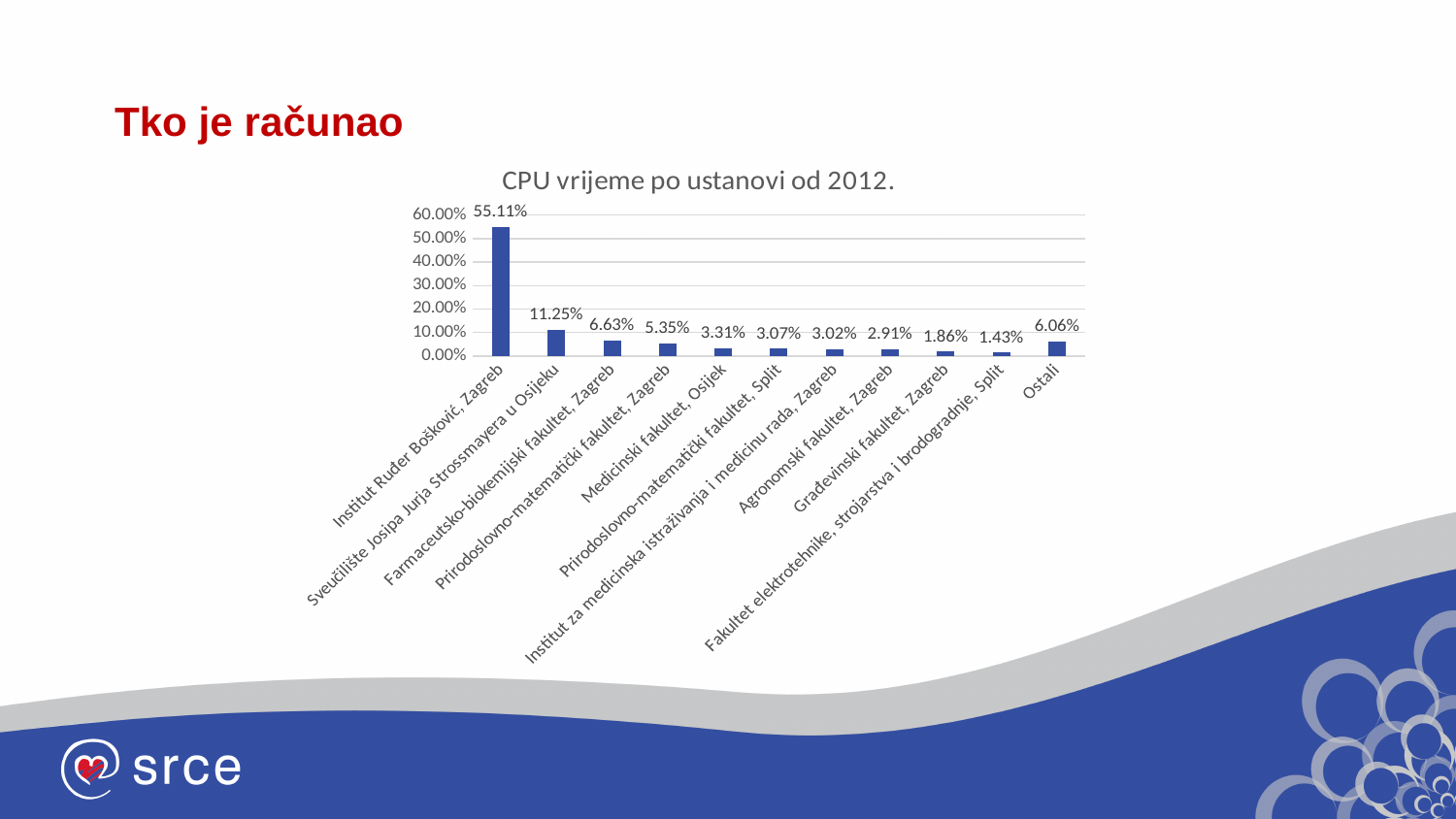
What is the difference between the values for Institut Ruđer Bošković, Zagreb and Sveučilište Josipa Jurja Strossmayera u Osijeku? 43.86% What is the value for Ostali? 6.06% What kind of chart is shown on the slide? bar chart What is the value for Medicinski fakultet, Osijek? 3.31% What is the value for Sveučilište Josipa Jurja Strossmayera u Osijeku? 11.25% Is the value for Institut Ruđer Bošković, Zagreb greater or less than 50.00%? greater Which institution has the highest share of CPU time? Institut Ruđer Bošković, Zagreb What is the title of the chart? CPU vrijeme po ustanovi od 2012. What is the value for Institut Ruđer Bošković, Zagreb? 55.11% How many categories (institutions) are shown on the x axis of the chart? 11 Which institution has the lowest share of CPU time? Fakultet elektrotehnike, strojarstva i brodogradnje, Split Which is larger: the value for Farmaceutsko-biokemijski fakultet, Zagreb or the value for Prirodoslovno-matematički fakultet, Zagreb? Farmaceutsko-biokemijski fakultet, Zagreb